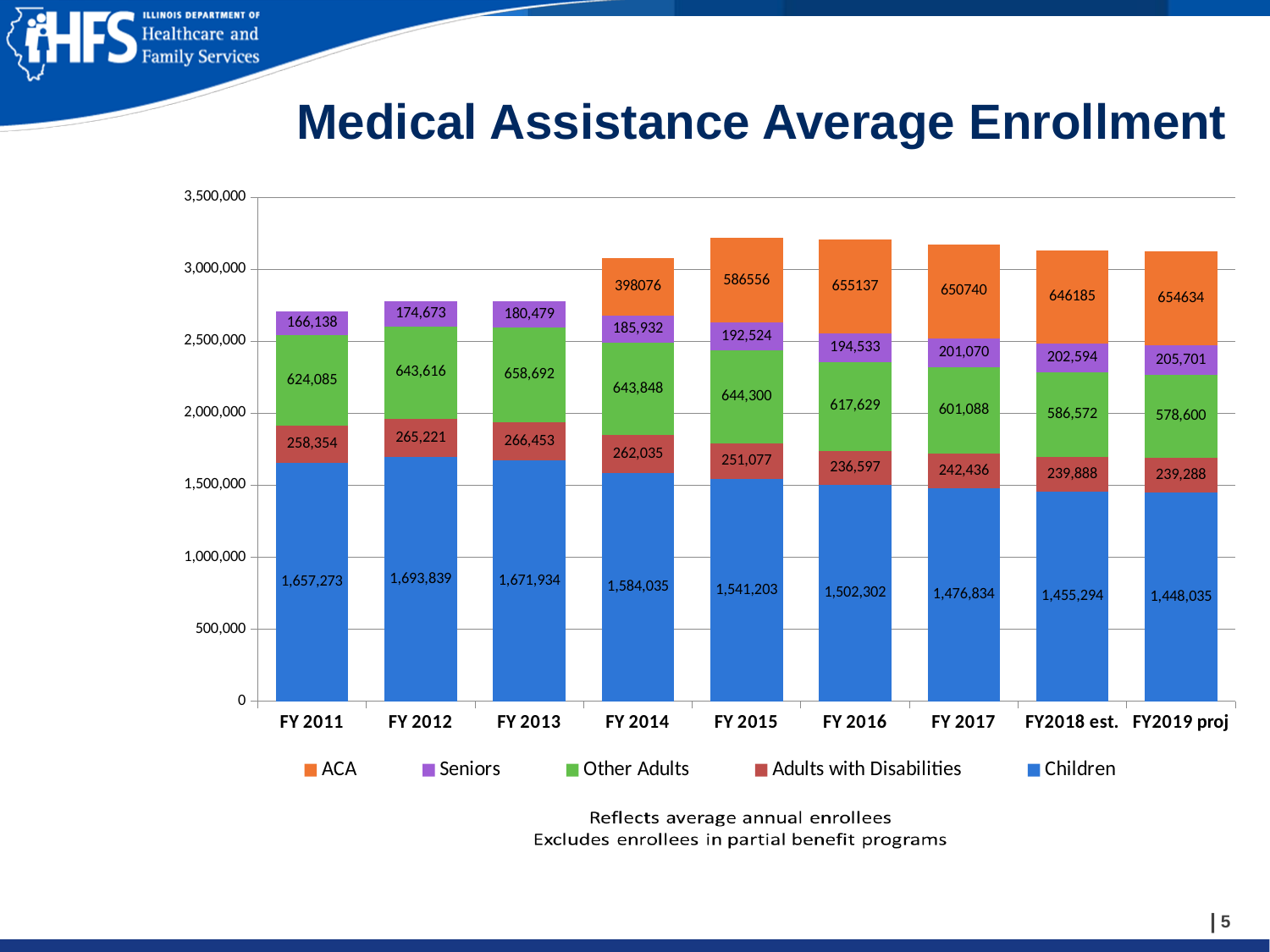
Which is larger, the Adults with Disabilities value in FY 2013 or in FY 2016? FY 2013 How many fiscal year categories are shown on the x axis? 9 What is the ACA enrollment value for FY 2016? 655137 What is the Children enrollment value for FY 2014? 1,584,035 How many series does the legend list? 5 In which fiscal year is the Other Adults value lowest? FY2019 proj Is the total enrollment for FY 2015 greater or less than 3,000,000? greater What is the Seniors value for FY2018 est.? 202,594 What type of chart is shown on the slide? Stacked bar chart In which fiscal year is the Children value highest? FY 2012 What is the difference between the Children value in FY 2011 and in FY2019 proj? 209,238 Do the Seniors values rise or fall from FY 2011 to FY2019 proj? Rise